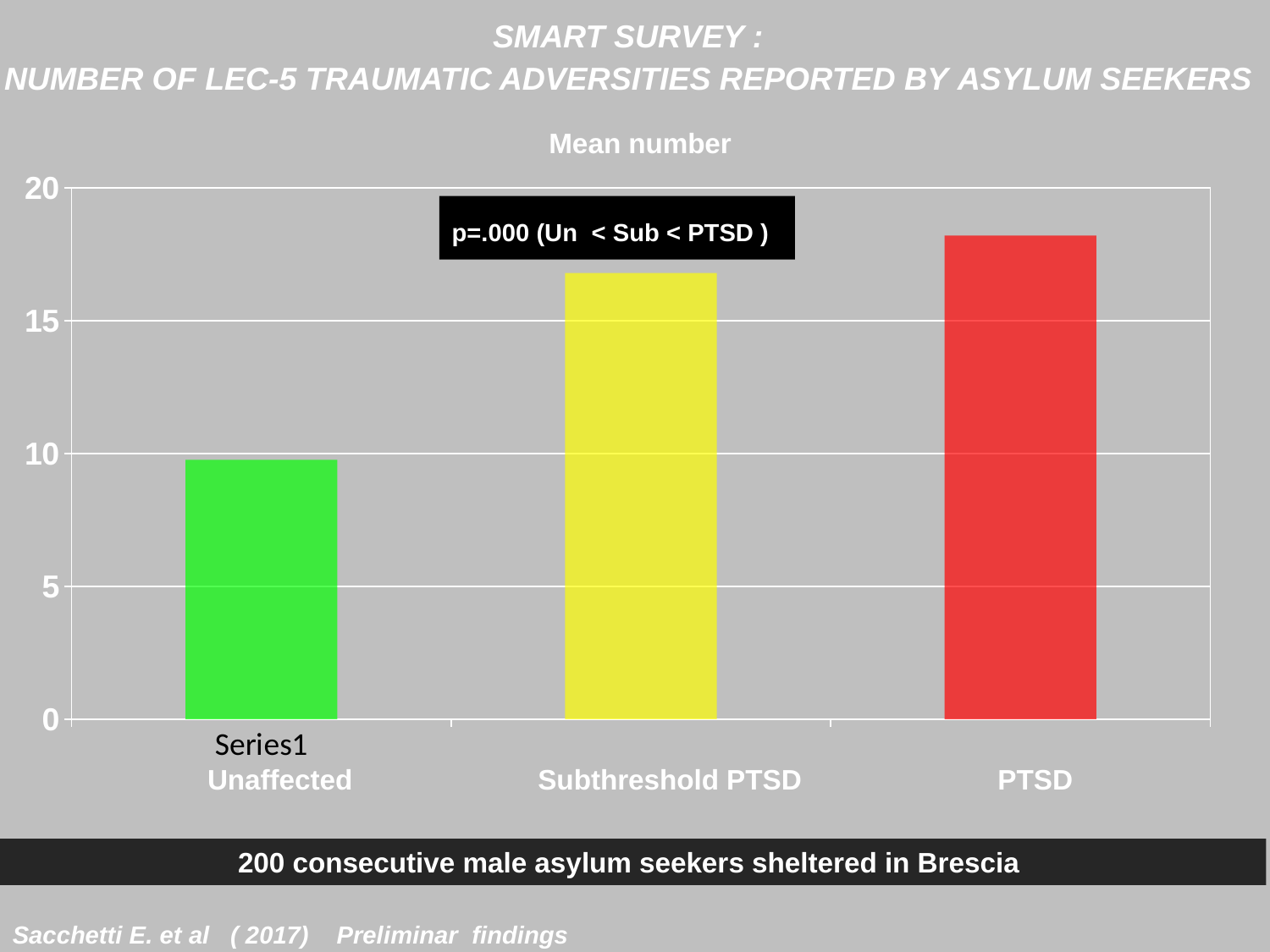
Is the value for Subthreshold PTSD greater or less than 15? greater Is the value for Unaffected greater or less than 10? less Which is larger, the value for Unaffected or the value for Subthreshold PTSD? Subthreshold PTSD Is the value for PTSD greater or less than 20? less What is the title shown directly above the chart's plot area? Mean number What kind of chart is shown on the slide? bar chart What colour is the bar for PTSD? red How many categories are plotted in the chart? 3 Which category has the lowest mean number of LEC-5 traumatic adversities? Unaffected Which category has the highest mean number of LEC-5 traumatic adversities? PTSD Do the values rise or fall moving from Unaffected to PTSD along the x axis? rise